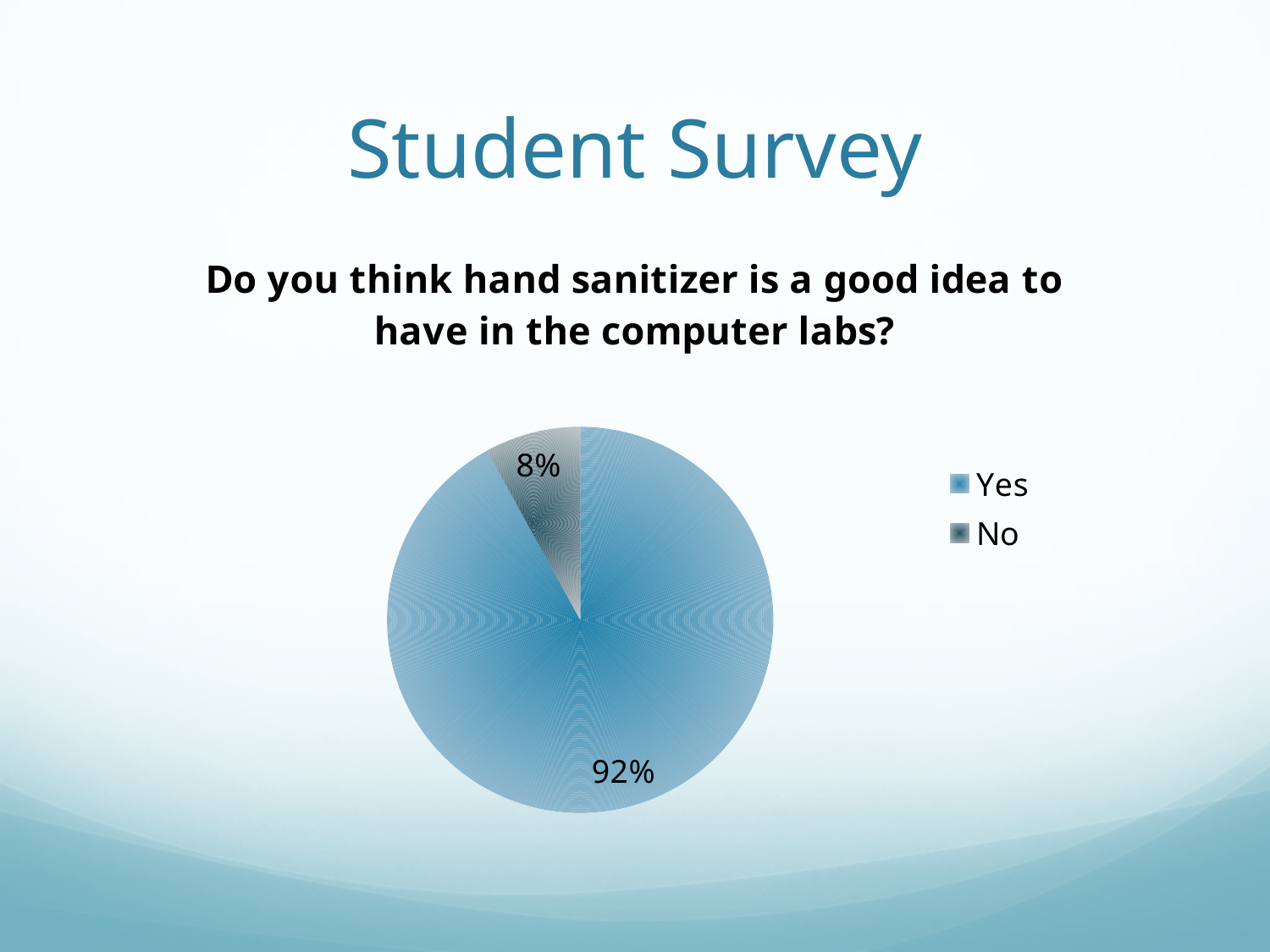
What percentage of students answered No? 8% What survey question does the chart answer? Do you think hand sanitizer is a good idea to have in the computer labs? What is the difference in percentage points between the Yes and No responses? 84 Which legend entry is shown in blue? Yes How many entries does the legend list? 2 What percentage of students answered Yes? 92% How many slices does the pie chart have? 2 Which is larger, the share for Yes or the share for No? Yes Which response has the smallest share of the pie? No What is the share of the pie taken by the No slice? 8% What type of chart is shown on the slide? pie chart Which response has the largest share of the pie? Yes